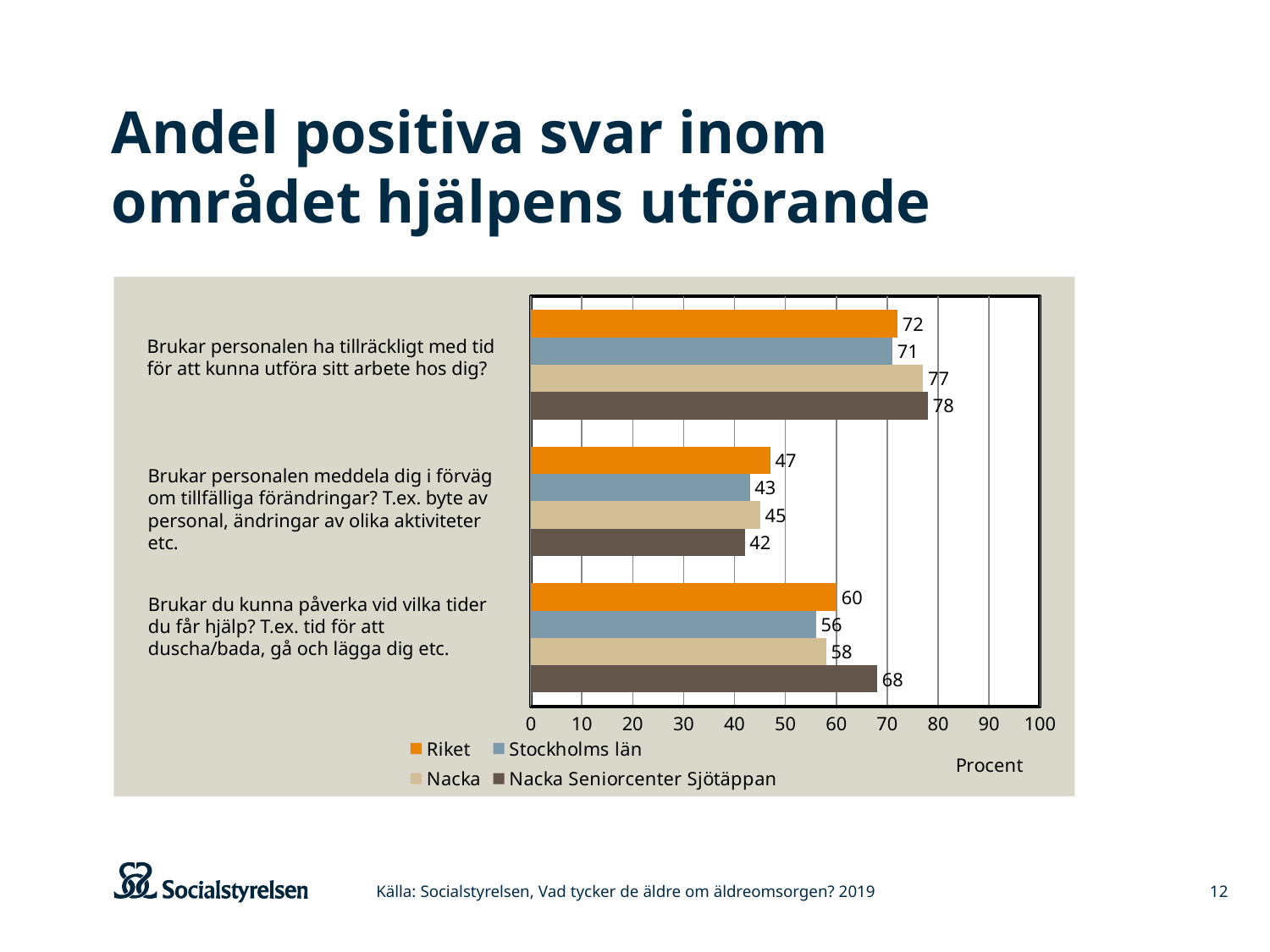
Which is larger on the question "Brukar personalen ha tillräckligt med tid för att kunna utföra sitt arbete hos dig?": Riket or Nacka? Nacka What is the value for Nacka Seniorcenter Sjötäppan on the question "Brukar personalen ha tillräckligt med tid för att kunna utföra sitt arbete hos dig?"? 78 Which series has the highest value on the question "Brukar du kunna påverka vid vilka tider du får hjälp?"? Nacka Seniorcenter Sjötäppan What kind of chart is shown on the slide? bar chart How many series does the legend list? 4 What is the difference between Nacka Seniorcenter Sjötäppan and Riket on the question "Brukar du kunna påverka vid vilka tider du får hjälp?"? 8 Which series has the lowest value on the question "Brukar personalen meddela dig i förväg om tillfälliga förändringar?"? Nacka Seniorcenter Sjötäppan How many questions (categories) are shown in the chart? 3 What is the label on the horizontal axis of the chart? Procent What is the value for Riket on the question "Brukar personalen meddela dig i förväg om tillfälliga förändringar?"? 47 Is the value for Nacka on the question "Brukar personalen meddela dig i förväg om tillfälliga förändringar?" greater or less than 50? less What is the value for Stockholms län on the question "Brukar du kunna påverka vid vilka tider du får hjälp?"? 56